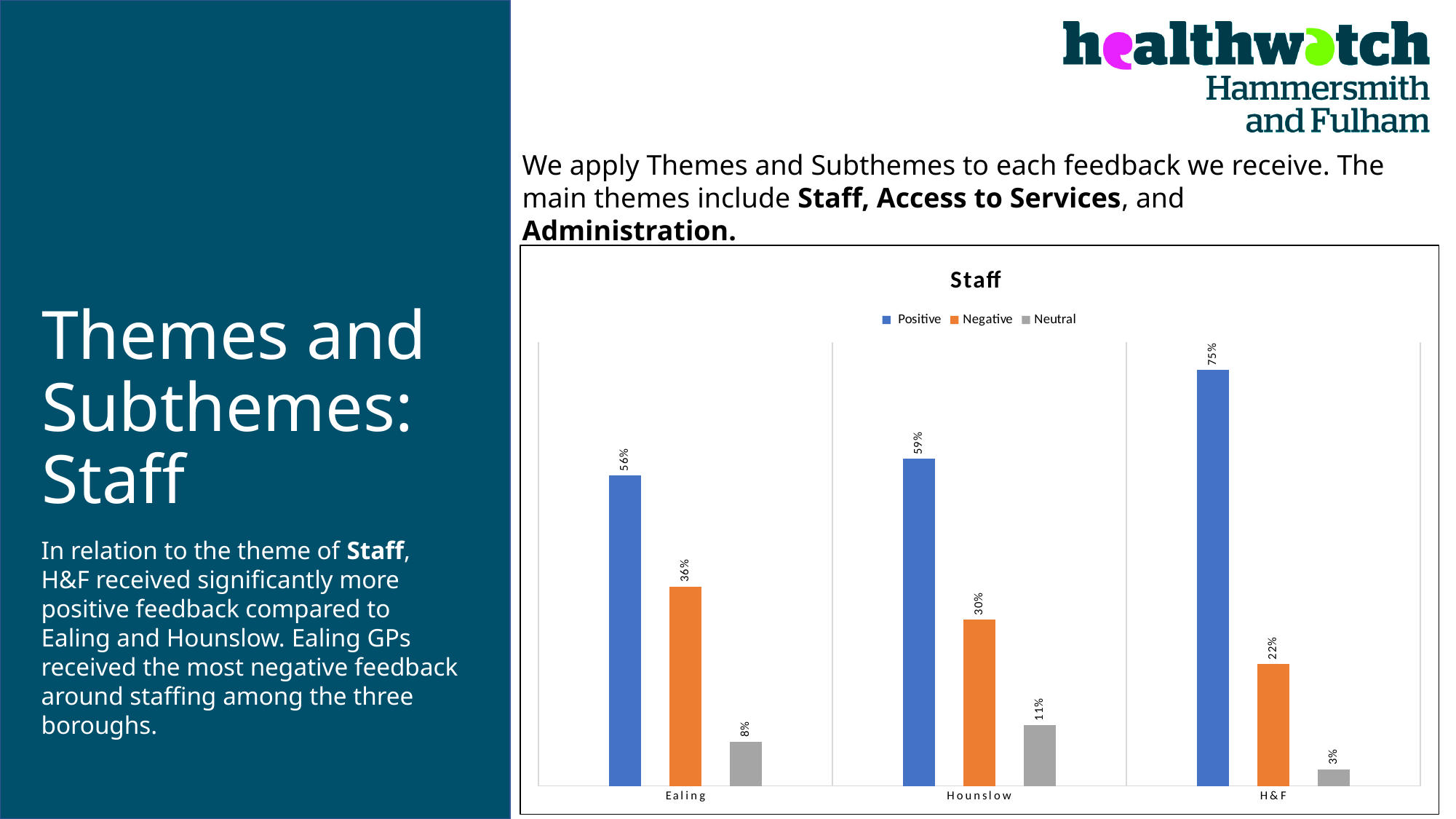
What is the difference between the Positive values for H&F and Ealing? 19% Which borough has the highest Positive value? H&F What is the Neutral value for Hounslow? 11% Which is larger, the Negative value for Hounslow or the Negative value for H&F? Hounslow What is the Negative value for Ealing? 36% What kind of chart is shown? Bar chart How many boroughs are shown on the x axis? 3 Which borough has the lowest Neutral value? H&F What is the title of the chart? Staff How many series does the legend list? 3 Which borough has the highest Negative value? Ealing What is the Positive value for H&F? 75%